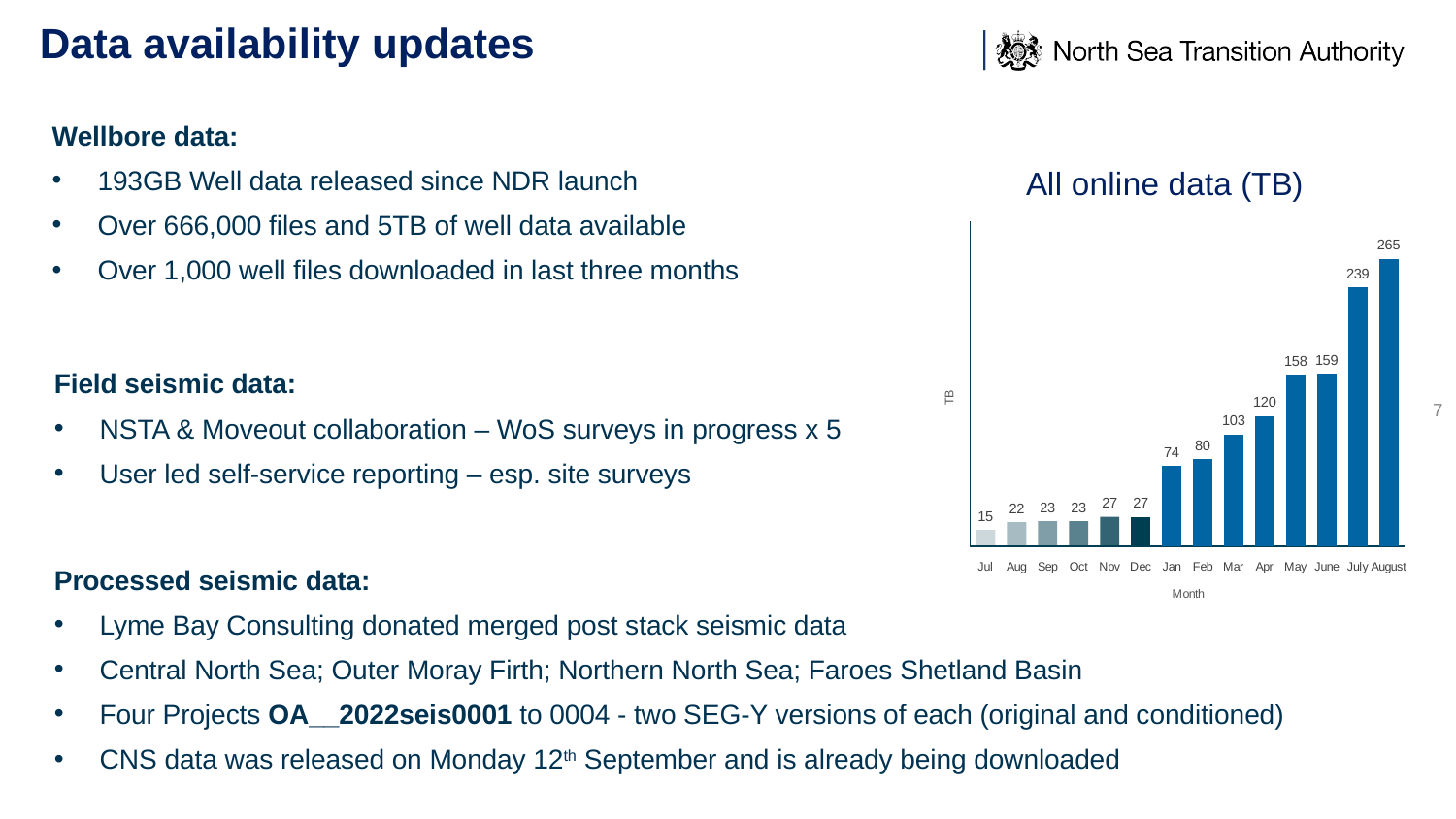
What kind of chart is the 'All online data (TB)' chart? bar chart Which month has the highest value in the 'All online data (TB)' chart? August What is the difference between the values for August and July in the 'All online data (TB)' chart? 26 Do the values in the 'All online data (TB)' chart generally rise or fall from Jul to August? rise What is the value for Jan in the 'All online data (TB)' chart? 74 How many months are shown on the x axis of the 'All online data (TB)' chart? 14 What is the value for August in the 'All online data (TB)' chart? 265 What is the difference between the values for Jan and Dec in the 'All online data (TB)' chart? 47 What is the x-axis label of the 'All online data (TB)' chart? Month What is the value for Apr in the 'All online data (TB)' chart? 120 Which month has the lowest value in the 'All online data (TB)' chart? Jul Which is larger in the 'All online data (TB)' chart, the value for Mar or the value for Feb? Mar